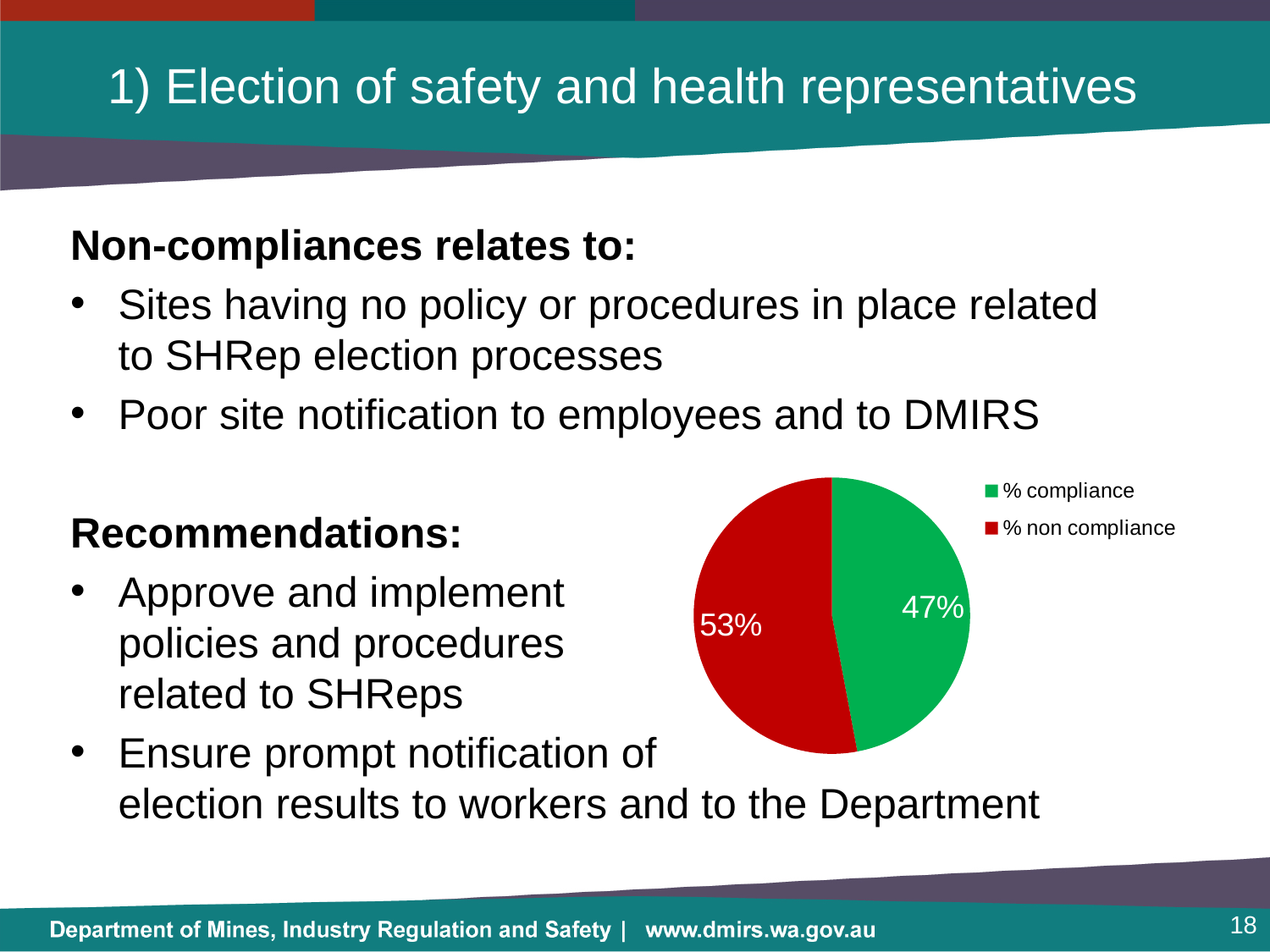
Which slice of the pie chart is the smallest? % compliance What is the difference between the % non compliance and % compliance slices? 6% How many slices does the pie chart have? 2 How many entries does the legend of the pie chart list? 2 What colour is the % compliance slice in the pie chart? green Which slice of the pie chart is the largest? % non compliance What kind of chart is shown on the slide? pie chart What colour is the % non compliance slice in the pie chart? red What share of the pie does the % compliance slice represent? 47% What is the value for % non compliance in the pie chart? 53% What is the value for % compliance in the pie chart? 47% Which is larger in the pie chart, % compliance or % non compliance? % non compliance